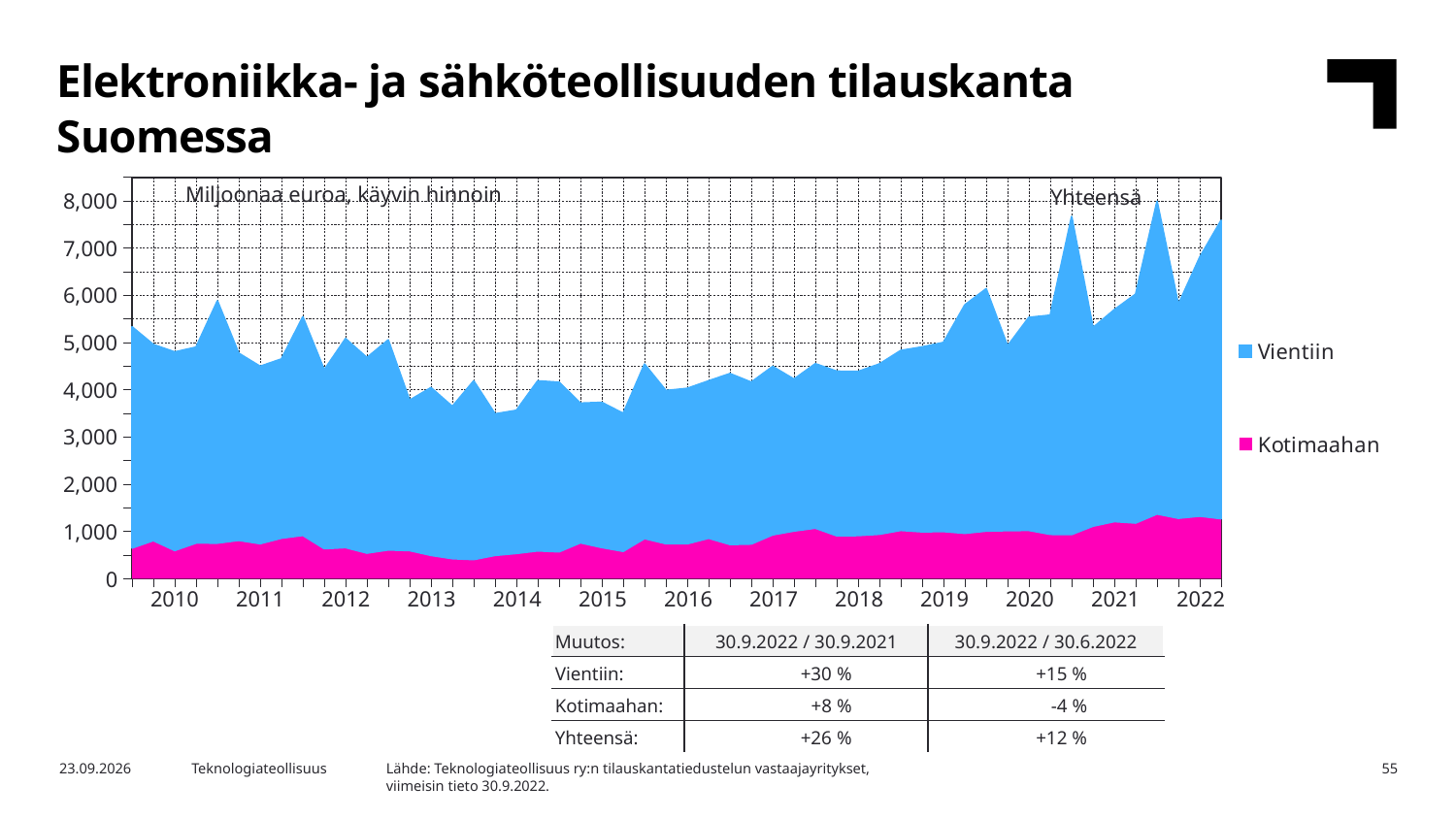
What is the highest value shown on the y axis? 8,000 Is the total (Yhteensä) value in 2014 greater or less than 5,000? less How many series does the legend list? 2 What is the title of the slide? Elektroniikka- ja sähköteollisuuden tilauskanta Suomessa What are the two series named in the legend? Vientiin and Kotimaahan How many year labels are shown on the x axis? 13 Is the Kotimaahan value in 2022 greater or less than 2,000? less What kind of chart is shown on the slide? Area chart Is the total (Yhteensä) value at the end of 2022 greater or less than 7,000? greater Does the total (Yhteensä) value generally rise or fall from 2019 to 2022? rise Which series is larger throughout the chart, Vientiin or Kotimaahan? Vientiin